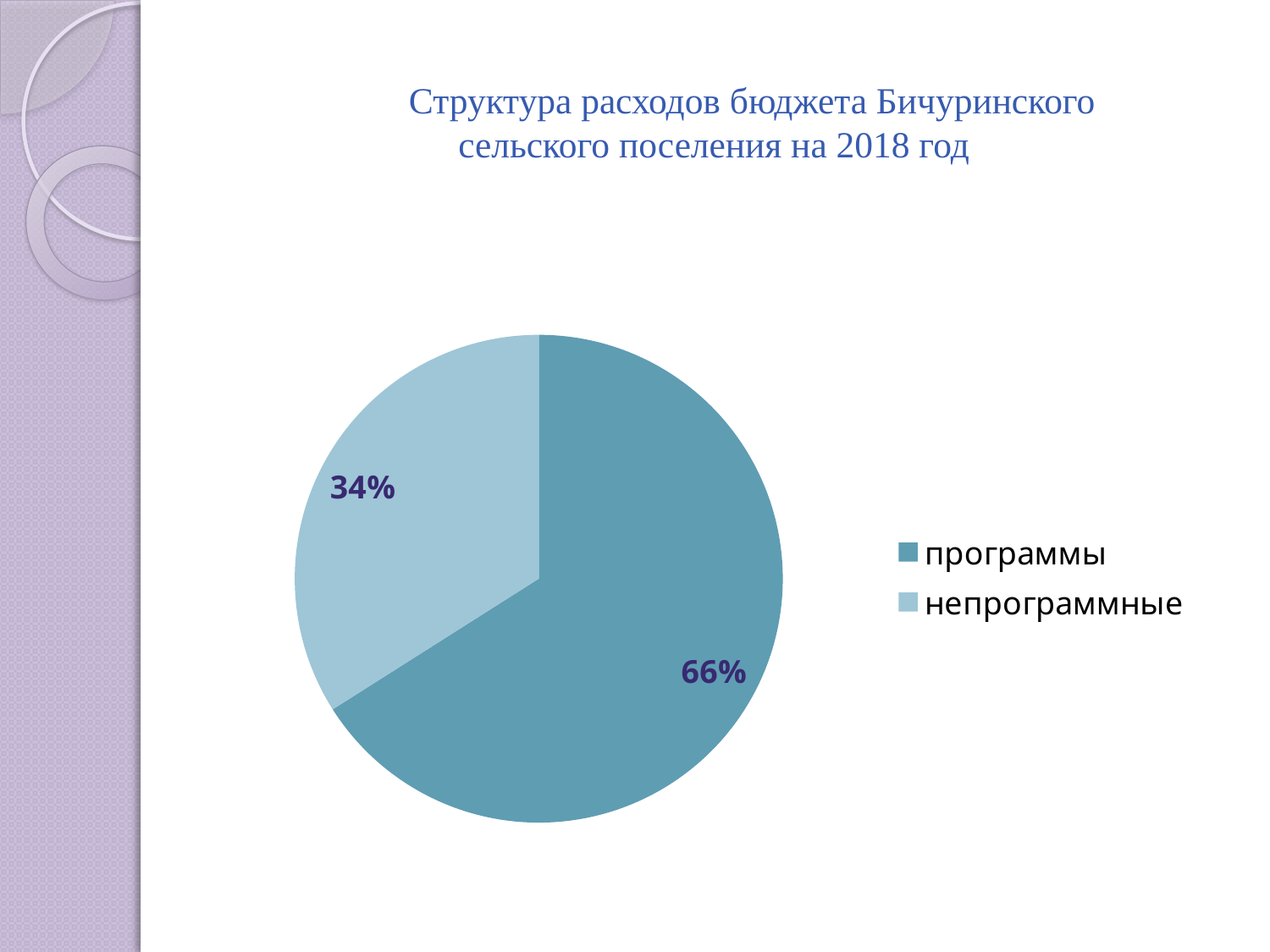
What share of the pie does the "программы" slice represent? 66% What is the title of the chart on the slide? Структура расходов бюджета Бичуринского сельского поселения на 2018 год Which category has the smallest slice of the pie? непрограммные What is the difference in percentage points between the "программы" and "непрограммные" slices? 32 percentage points How many entries does the legend list? 2 Which legend entry is shown in the lighter blue colour? непрограммные Which is larger, the "программы" slice or the "непрограммные" slice? программы How many slices does the pie chart have? 2 What share of the pie does the "непрограммные" slice represent? 34% Which category has the largest slice of the pie? программы What kind of chart is shown on the slide? pie chart